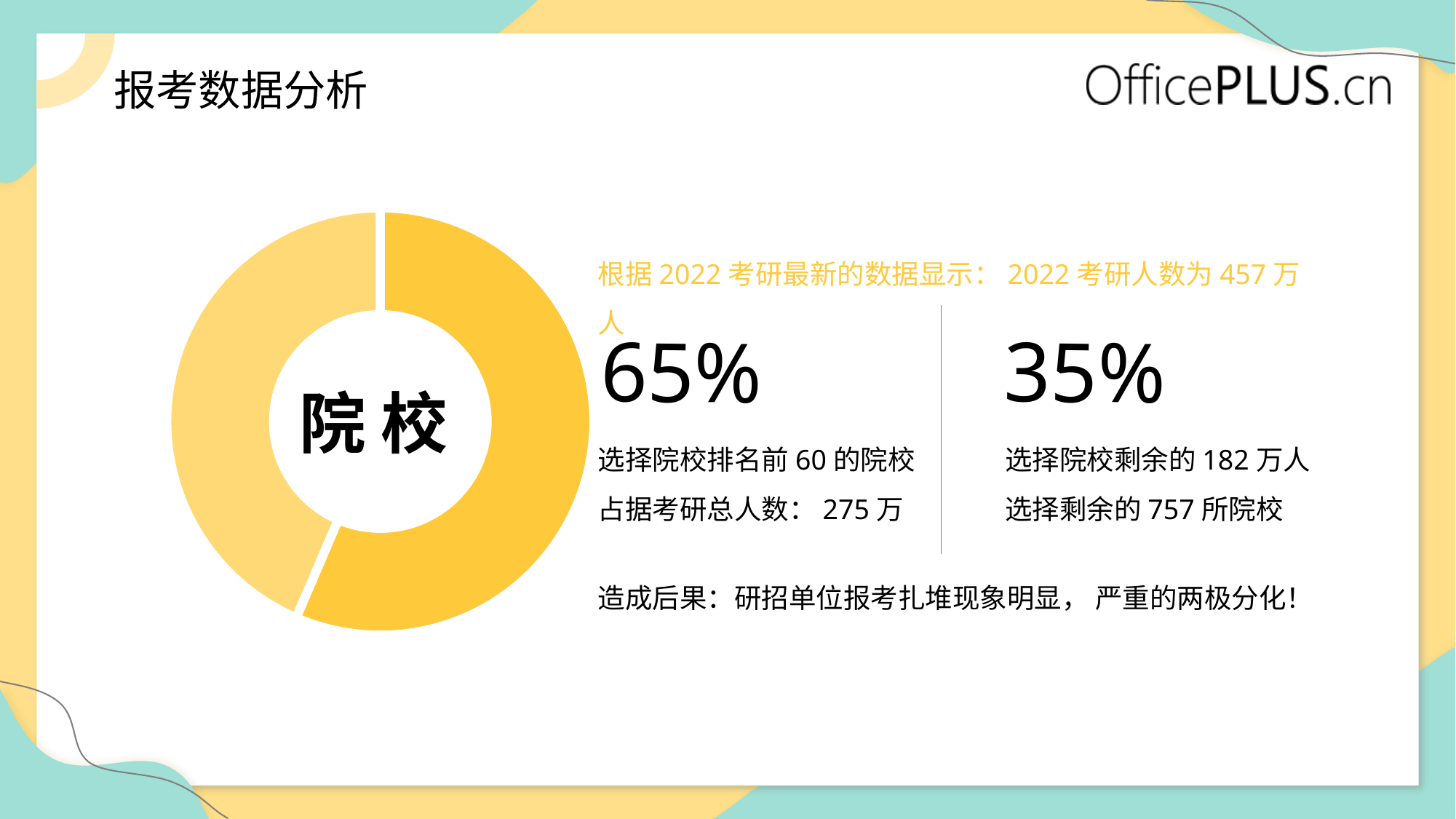
How many slices does the donut chart have? 2 What kind of chart is shown on the slide? Donut (pie) chart What share of candidates chose universities ranked in the top 60? 65% Which group is larger: candidates choosing top-60 universities or candidates choosing the remaining universities? Top-60 universities (65%) What share of candidates chose the remaining 757 universities? 35% What is the total number of 2022 postgraduate exam candidates stated on the slide? 457 万人 Which slice of the donut chart is the smallest? The lighter yellow slice on the left How many people (in 万) chose universities ranked in the top 60? 275 万 How many people (in 万) chose the remaining 757 universities? 182 万 Which slice of the donut chart is the largest? The darker yellow slice on the right What text is written in the centre of the donut chart? 院校